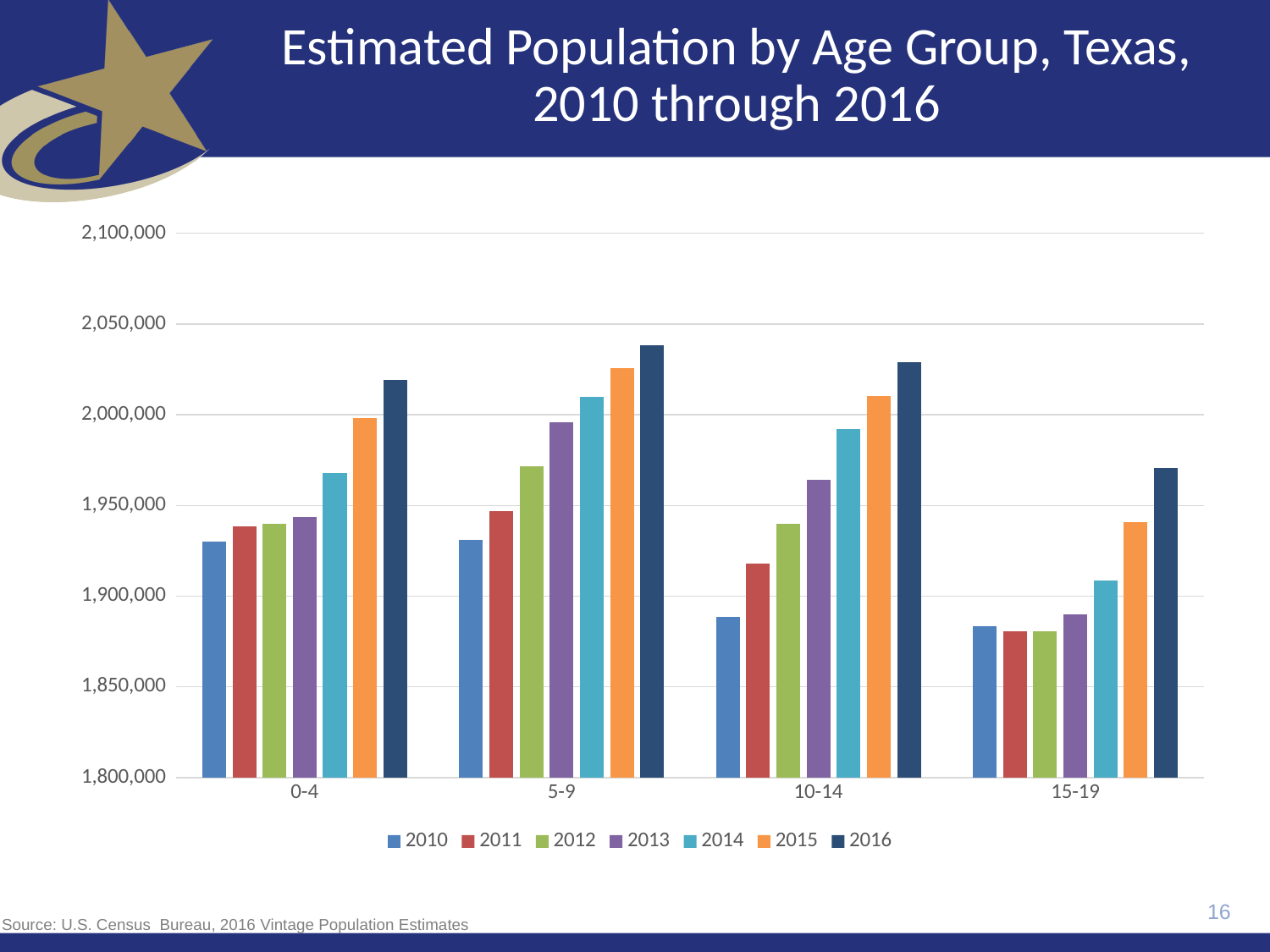
How many age groups are shown on the x axis? 4 What is the title of the chart? Estimated Population by Age Group, Texas, 2010 through 2016 Is the 2015 value for the 5-9 age group greater or less than 2,000,000? greater How many series does the legend list? 7 What source is cited for the chart data? U.S. Census Bureau, 2016 Vintage Population Estimates What kind of chart is shown on the slide? bar chart Which age group has the highest 2016 value? 5-9 Within the 5-9 age group, do the values rise or fall from 2010 to 2016? rise Is the 2016 value for the 0-4 age group greater or less than 2,000,000? greater Which age group has the lowest 2016 value? 15-19 Which is larger, the 2014 value for the 5-9 age group or the 2014 value for the 0-4 age group? 5-9 Is the 2010 value for the 10-14 age group greater or less than 1,900,000? less